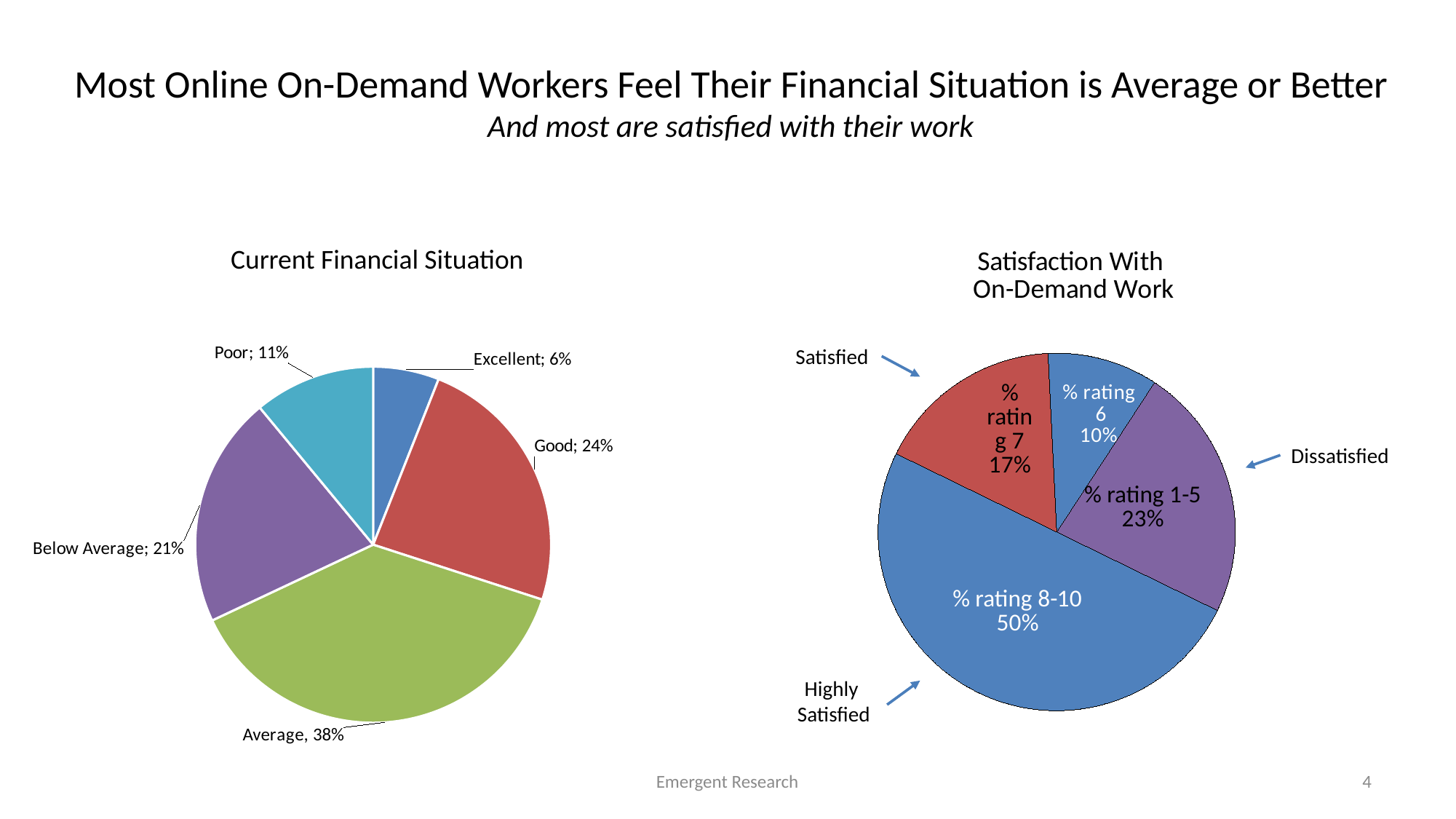
In the Current Financial Situation chart, which category has the smallest share? Excellent In the Current Financial Situation chart, what is the difference between the Good and Poor shares? 13% In the Satisfaction With On-Demand Work chart, what percentage of workers gave a rating of 1-5? 23% In the Satisfaction With On-Demand Work chart, what is the combined share of workers rating 6 and rating 7? 27% In the Current Financial Situation chart, what percentage of workers rate their situation as Excellent? 6% In the Current Financial Situation chart, which is larger: Below Average or Good? Good What type of chart is the Current Financial Situation chart? Pie chart In the Satisfaction With On-Demand Work chart, which slice is the smallest? % rating 6 In the Satisfaction With On-Demand Work chart, what percentage of workers gave a rating of 8-10? 50% In the Current Financial Situation chart, which category has the largest share? Average How many categories are shown in the Current Financial Situation chart? 5 In the Current Financial Situation chart, what percentage of workers rate their situation as Average? 38%